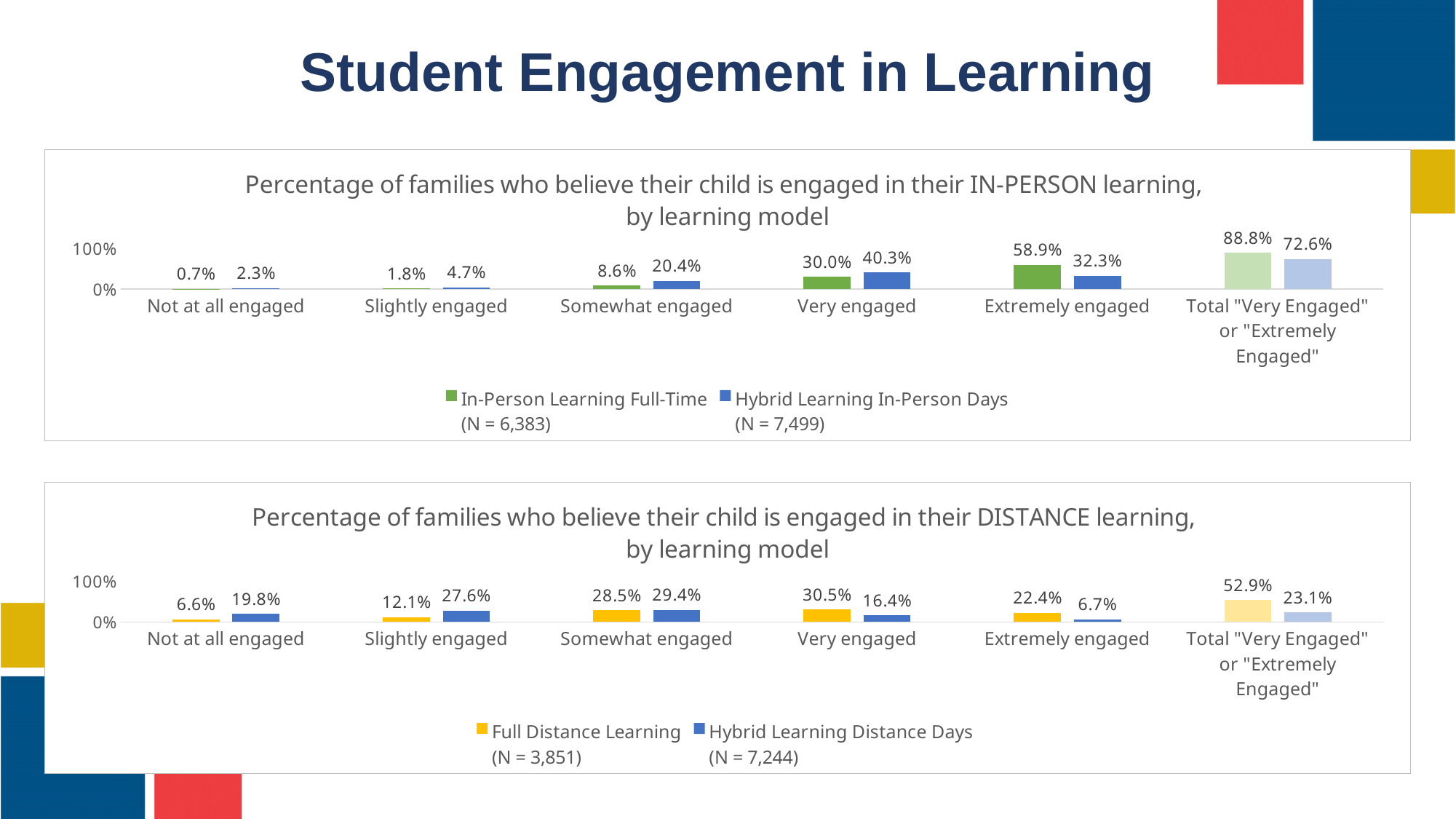
How many categories are shown on the x axis of the DISTANCE learning chart? 6 In the IN-PERSON learning chart, what percentage of In-Person Learning Full-Time families said their child is extremely engaged? 58.9% What type of chart is the DISTANCE learning chart? Bar chart In the DISTANCE learning chart, what is the difference between the Full Distance Learning and Hybrid Learning Distance Days values for Total "Very Engaged" or "Extremely Engaged"? 29.8 percentage points In the IN-PERSON learning chart, which series has the larger value for Very engaged? Hybrid Learning In-Person Days In the DISTANCE learning chart, what is the Full Distance Learning value for Very engaged? 30.5% In the IN-PERSON learning chart, what is the difference between the In-Person Learning Full-Time and Hybrid Learning In-Person Days values for Extremely engaged? 26.6 percentage points In the IN-PERSON learning chart, what is the Hybrid Learning In-Person Days value for Somewhat engaged? 20.4% How many series does the legend of the IN-PERSON learning chart list? 2 In the DISTANCE learning chart, which category has the highest value for Hybrid Learning Distance Days? Somewhat engaged In the IN-PERSON learning chart, which category has the lowest value for In-Person Learning Full-Time? Not at all engaged In the DISTANCE learning chart, what is the Hybrid Learning Distance Days value for Not at all engaged? 19.8%